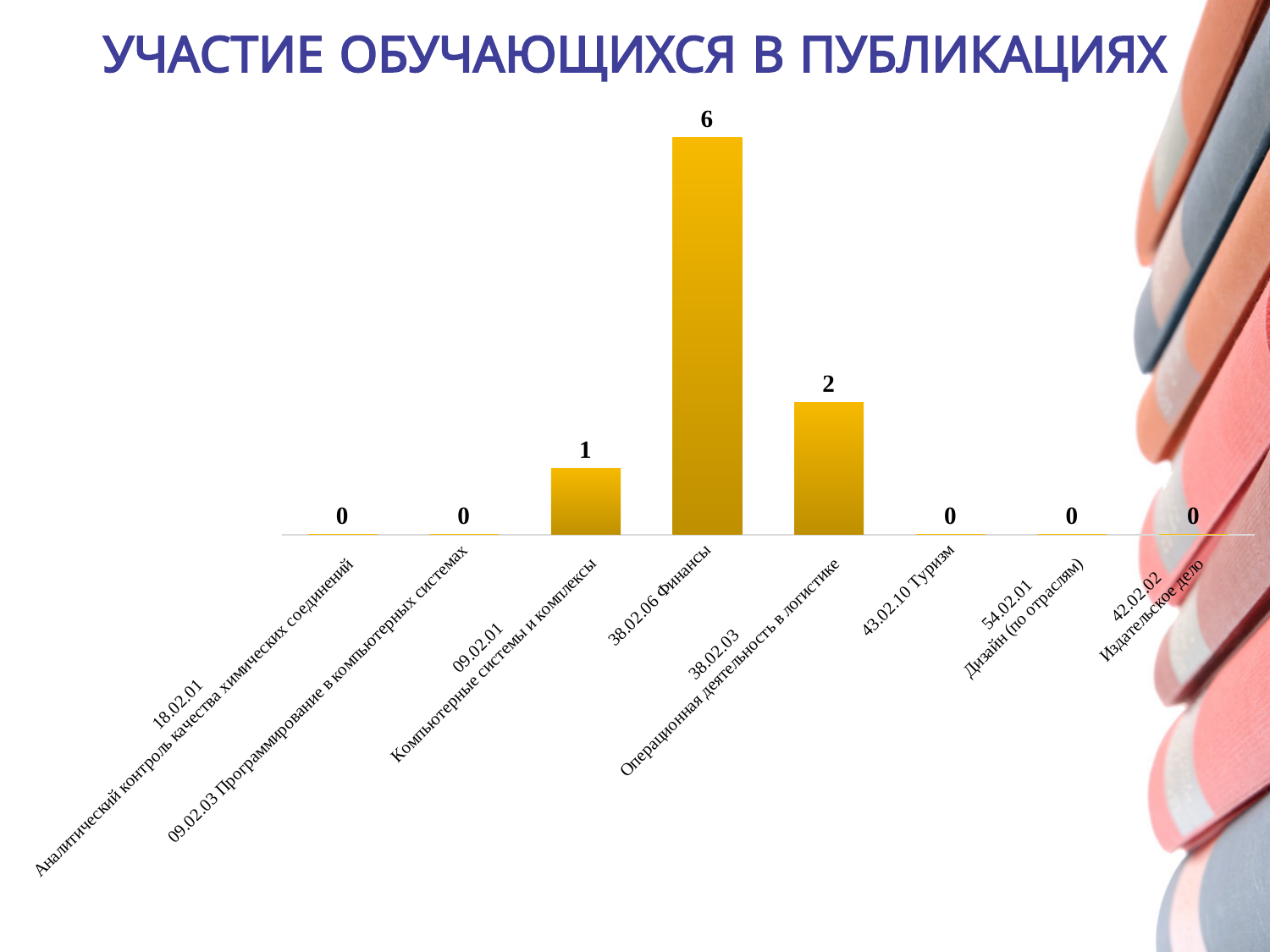
What is the value for 38.02.06 Финансы? 6 What is the value for 38.02.03 Операционная деятельность в логистике? 2 What is the value for 09.02.01 Компьютерные системы и комплексы? 1 What is the value for 54.02.01 Дизайн (по отраслям)? 0 What is the difference between the values for 38.02.03 Операционная деятельность в логистике and 09.02.01 Компьютерные системы и комплексы? 1 How many categories are shown on the x axis? 8 Which category has the highest value? 38.02.06 Финансы What kind of chart is shown on the slide? Bar chart What is the difference between the values for 38.02.06 Финансы and 38.02.03 Операционная деятельность в логистике? 4 What is the title of the slide? УЧАСТИЕ ОБУЧАЮЩИХСЯ В ПУБЛИКАЦИЯХ Which is larger, the value for 09.02.01 Компьютерные системы и комплексы or the value for 38.02.03 Операционная деятельность в логистике? 38.02.03 Операционная деятельность в логистике What is the value for 43.02.10 Туризм? 0